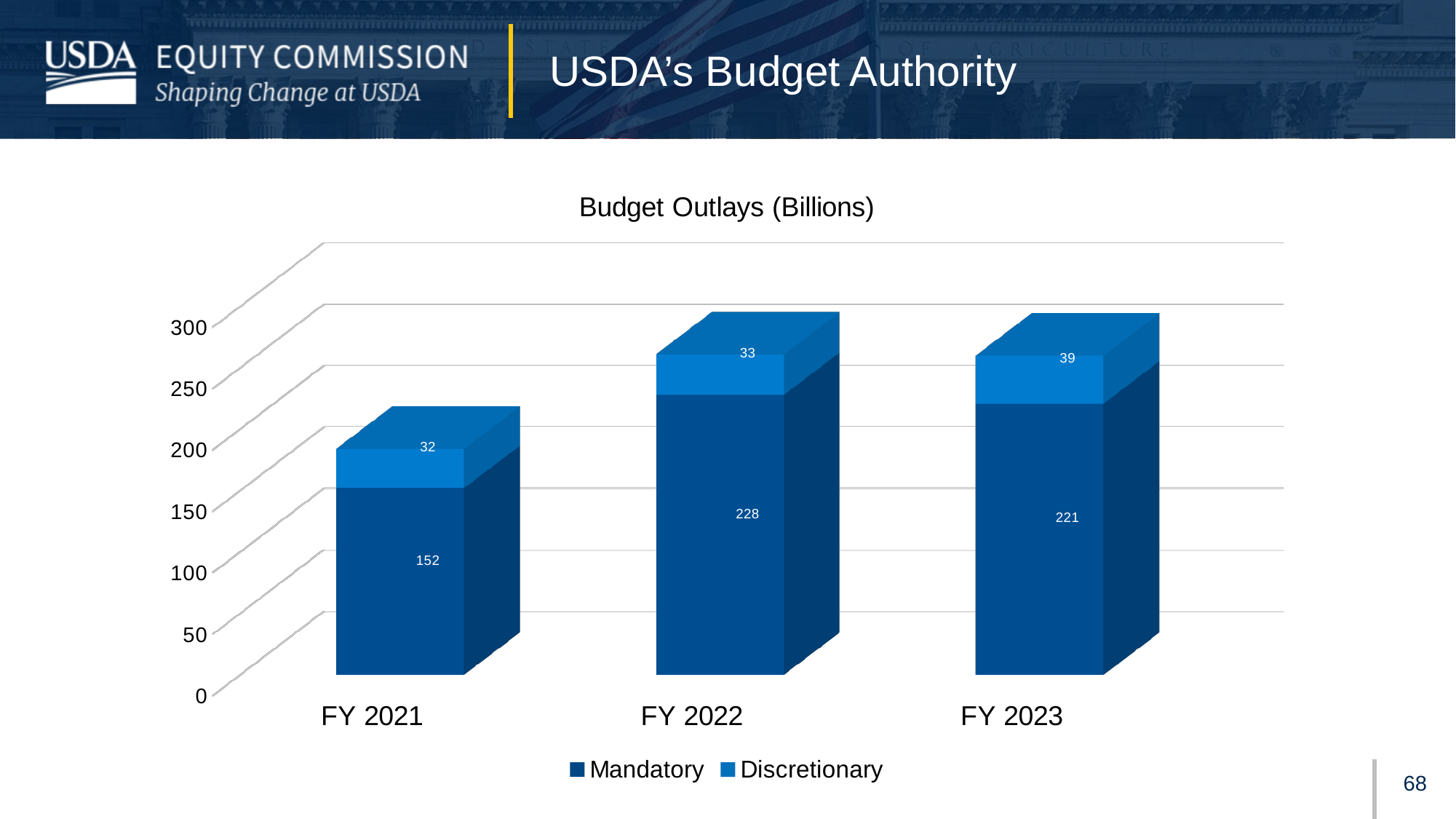
What is the total of the stacked bar for FY 2023? 260 What is the title of the chart? Budget Outlays (Billions) What is the Discretionary value for FY 2023? 39 How many series does the legend list? 2 What is the Mandatory value for FY 2022? 228 Which fiscal year has the lowest Discretionary value? FY 2021 What is the difference between the Mandatory values for FY 2022 and FY 2023? 7 Is the Discretionary value larger in FY 2022 or FY 2023? FY 2023 What is the total of the stacked bar for FY 2021? 184 How many fiscal years are shown on the x axis? 3 Which fiscal year has the highest Mandatory value? FY 2022 What is the Mandatory value for FY 2021? 152